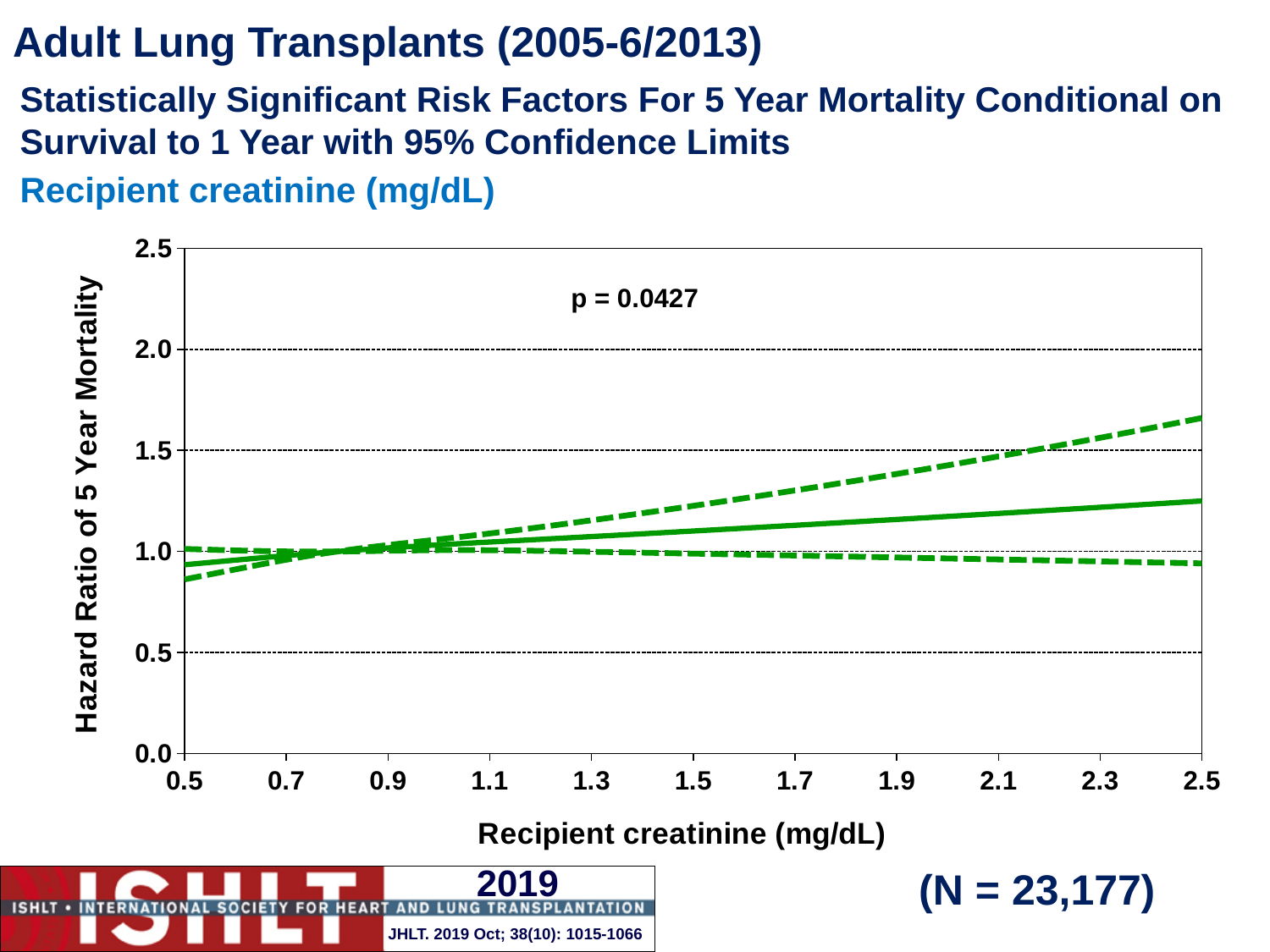
Is the lower dashed confidence limit at a recipient creatinine of 2.5 mg/dL greater or less than 1.0? less Is the upper dashed confidence limit at a recipient creatinine of 2.5 mg/dL greater or less than 1.5? greater Does the solid hazard ratio line rise or fall as recipient creatinine increases from 0.5 to 2.5 mg/dL? rise How many lines are plotted on the chart? 3 Is the lower dashed confidence limit at a recipient creatinine of 0.5 mg/dL greater or less than 1.0? less What sample size (N) is shown on the slide? N = 23,177 What p-value is printed on the chart? p = 0.0427 What kind of chart is shown on the slide? line chart Which is larger at a recipient creatinine of 2.5 mg/dL: the upper dashed confidence limit or the solid line? the upper dashed confidence limit